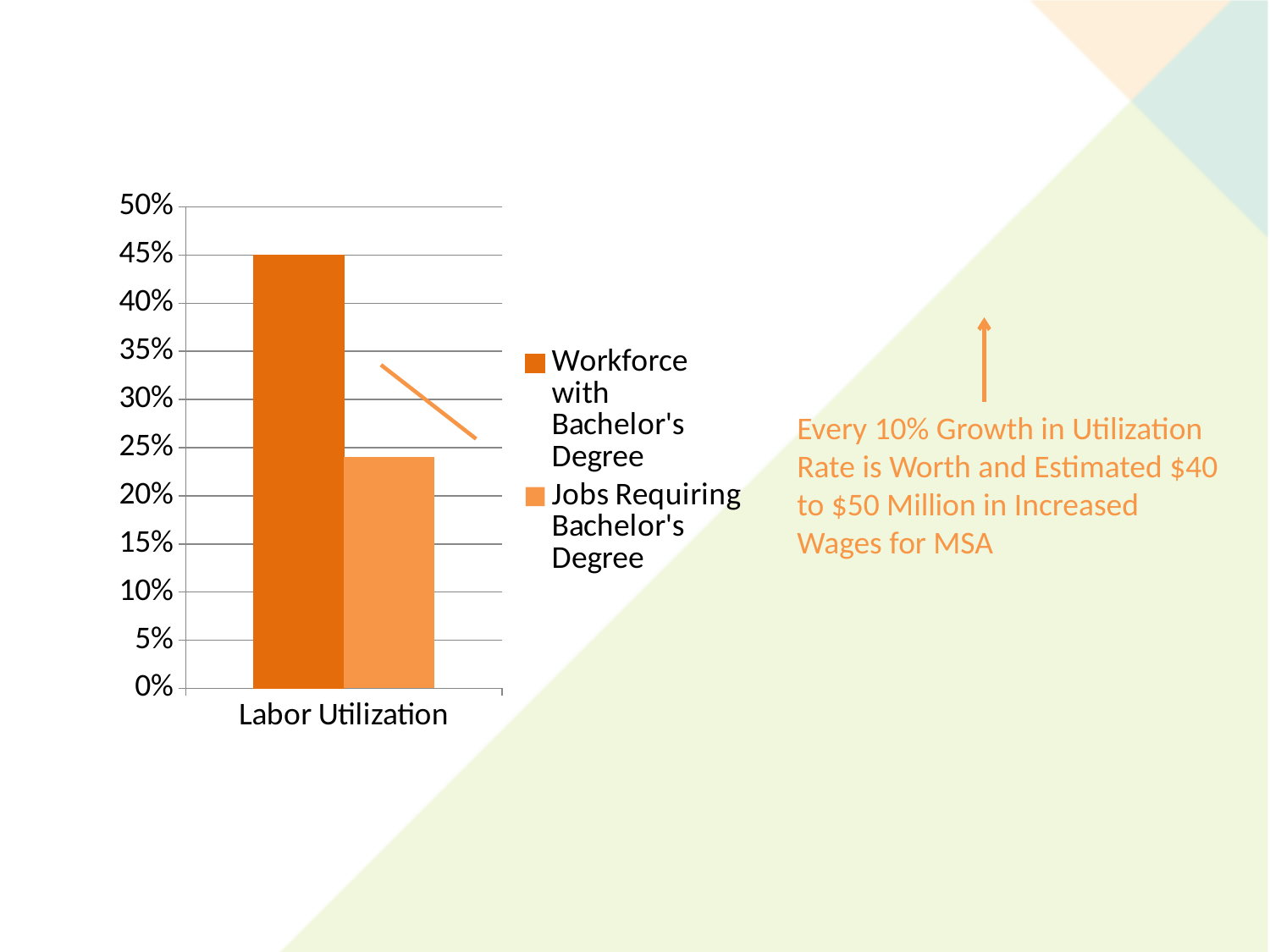
Is the value for Workforce with Bachelor's Degree greater or less than 40%? greater How many series does the chart's legend list? 2 What is the value for Workforce with Bachelor's Degree in the Labor Utilization chart? 45% Which series has the highest value in the chart? Workforce with Bachelor's Degree What is the highest value shown on the chart's y axis? 50% Which series has the lowest value in the chart? Jobs Requiring Bachelor's Degree Is the value for Jobs Requiring Bachelor's Degree greater or less than 25%? less How many categories are shown on the x axis of the chart? 1 What is the category label shown on the x axis of the chart? Labor Utilization Which is larger, Workforce with Bachelor's Degree or Jobs Requiring Bachelor's Degree? Workforce with Bachelor's Degree Is the value for Jobs Requiring Bachelor's Degree greater or less than 20%? greater What kind of chart is shown on the slide? bar chart